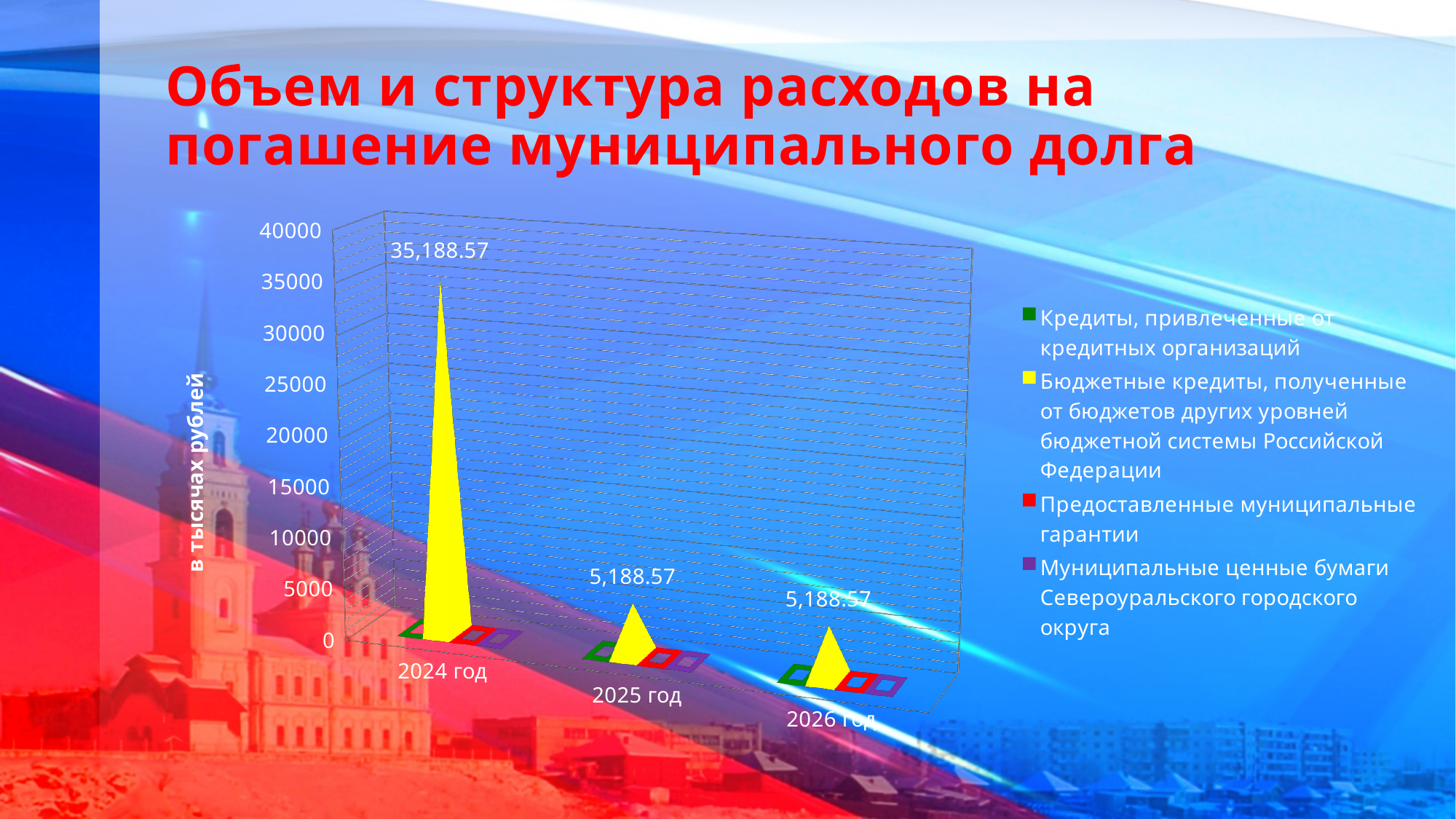
Which is larger for the yellow series 'Бюджетные кредиты': the value for 2024 год or for 2026 год? 2024 год What is the label on the vertical axis of the chart? в тысячах рублей How many years (categories) are shown on the x axis of the chart? 3 What is the difference between the 2024 год and 2025 год values for the yellow series 'Бюджетные кредиты'? 30,000 Is the value for 2024 год for the yellow series greater or less than 30000? greater How does the value of the yellow series 'Бюджетные кредиты' change from 2024 год to 2026 год? It falls from 2024 to 2025, then stays the same Is the value for 2025 год for the yellow series greater or less than 10000? less What is the value shown for 2025 год for the series 'Бюджетные кредиты, полученные от бюджетов других уровней бюджетной системы Российской Федерации'? 5,188.57 What is the value shown for 2026 год for the series 'Бюджетные кредиты, полученные от бюджетов других уровней бюджетной системы Российской Федерации'? 5,188.57 Which year has the highest value for the yellow series 'Бюджетные кредиты'? 2024 год What is the value shown for 2024 год for the series 'Бюджетные кредиты, полученные от бюджетов других уровней бюджетной системы Российской Федерации'? 35,188.57 How many series does the chart legend list? 4